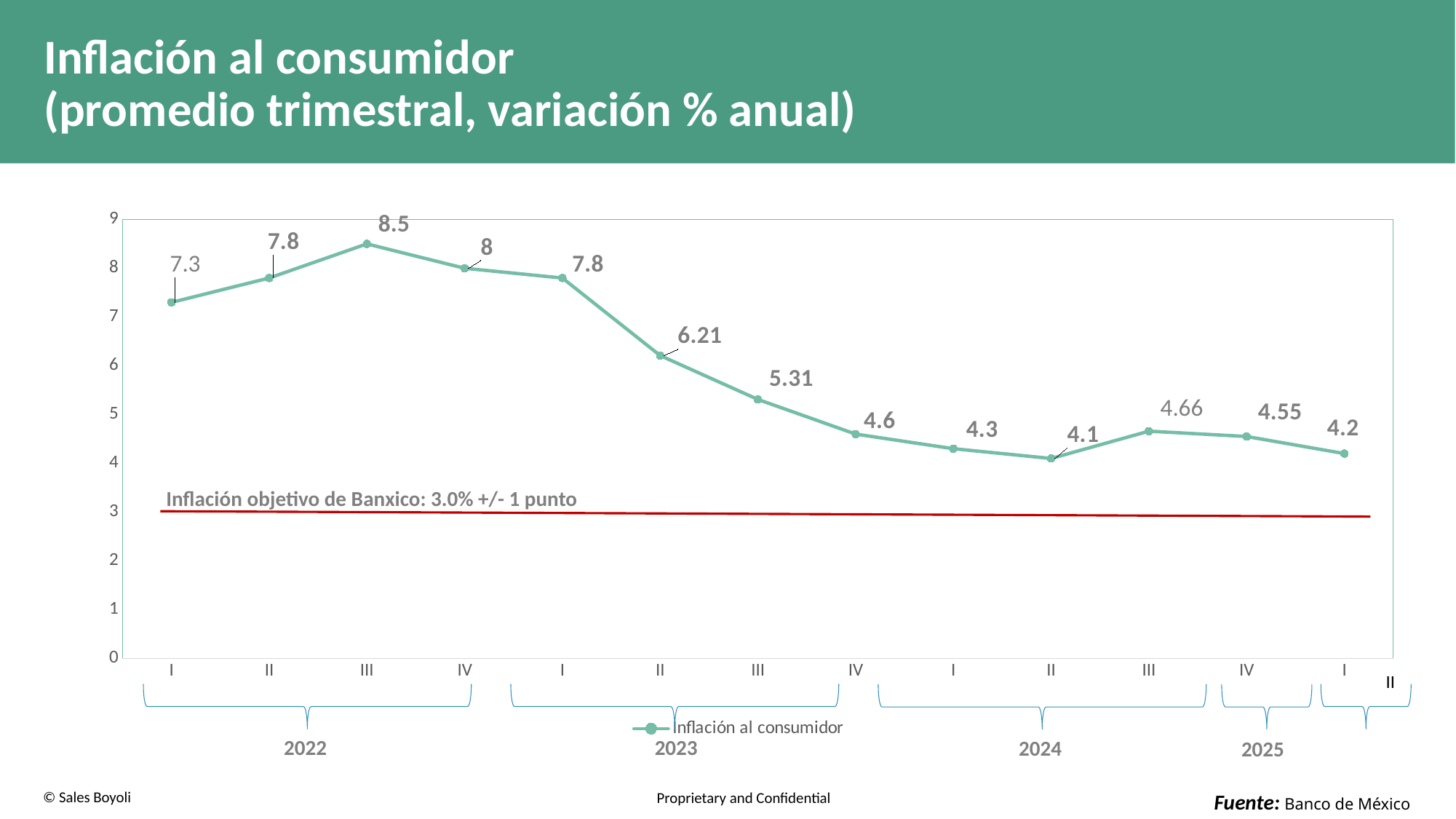
What is the value for quarter II of 2023? 6.21 Which quarter has the highest inflation value? III 2022 Do the values rise or fall from quarter I of 2023 to quarter II of 2024? fall Which is larger, the value for quarter III of 2024 or quarter IV of 2024? III 2024 What is the difference between the values for quarter III of 2022 and quarter I of 2022? 1.2 Which quarter has the lowest inflation value? II 2024 What type of chart is shown on the slide? line chart How many series does the legend list? 1 How many data points are plotted on the line? 13 Is the value for quarter IV of 2023 greater or less than 5? less What is the value for quarter I of 2025? 4.2 What is the value for quarter III of 2022? 8.5